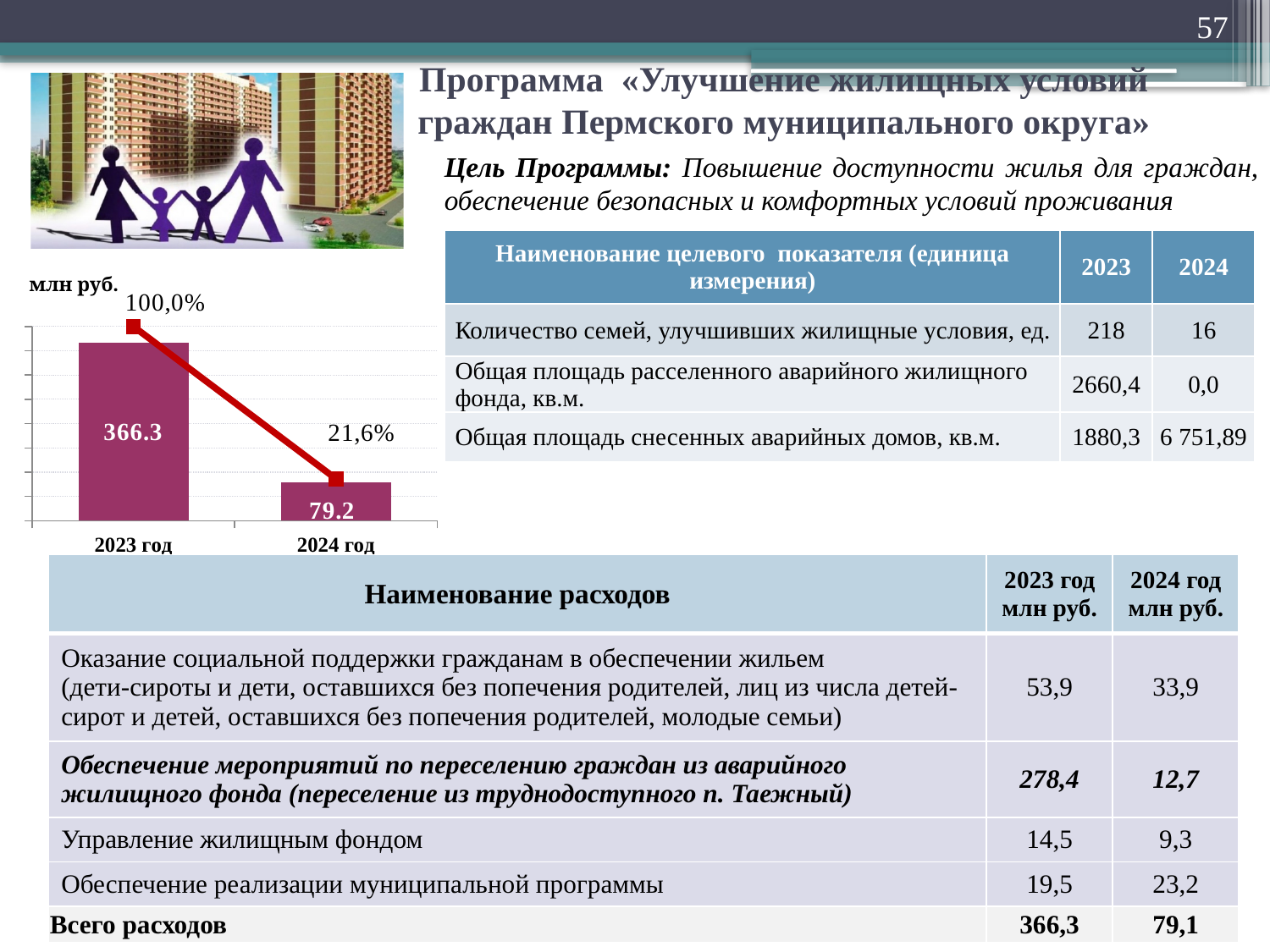
What percentage label is shown above the 2024 год bar in the chart? 21,6% What is the value for 2023 год in the bar chart? 366.3 How many bars are shown in the chart? 2 Which year has the lowest bar in the chart? 2024 год Do the bar values rise or fall from 2023 год to 2024 год? fall What is the value for 2024 год in the bar chart? 79.2 Which is larger in the bar chart, the value for 2023 год or for 2024 год? 2023 год What kind of chart is shown on the slide? combination bar and line chart What unit is indicated above the chart's vertical axis? млн руб. What is the difference between the 2023 год and 2024 год bar values in the chart? 287.1 What percentage label is shown above the 2023 год bar in the chart? 100,0% Which year has the highest bar in the chart? 2023 год